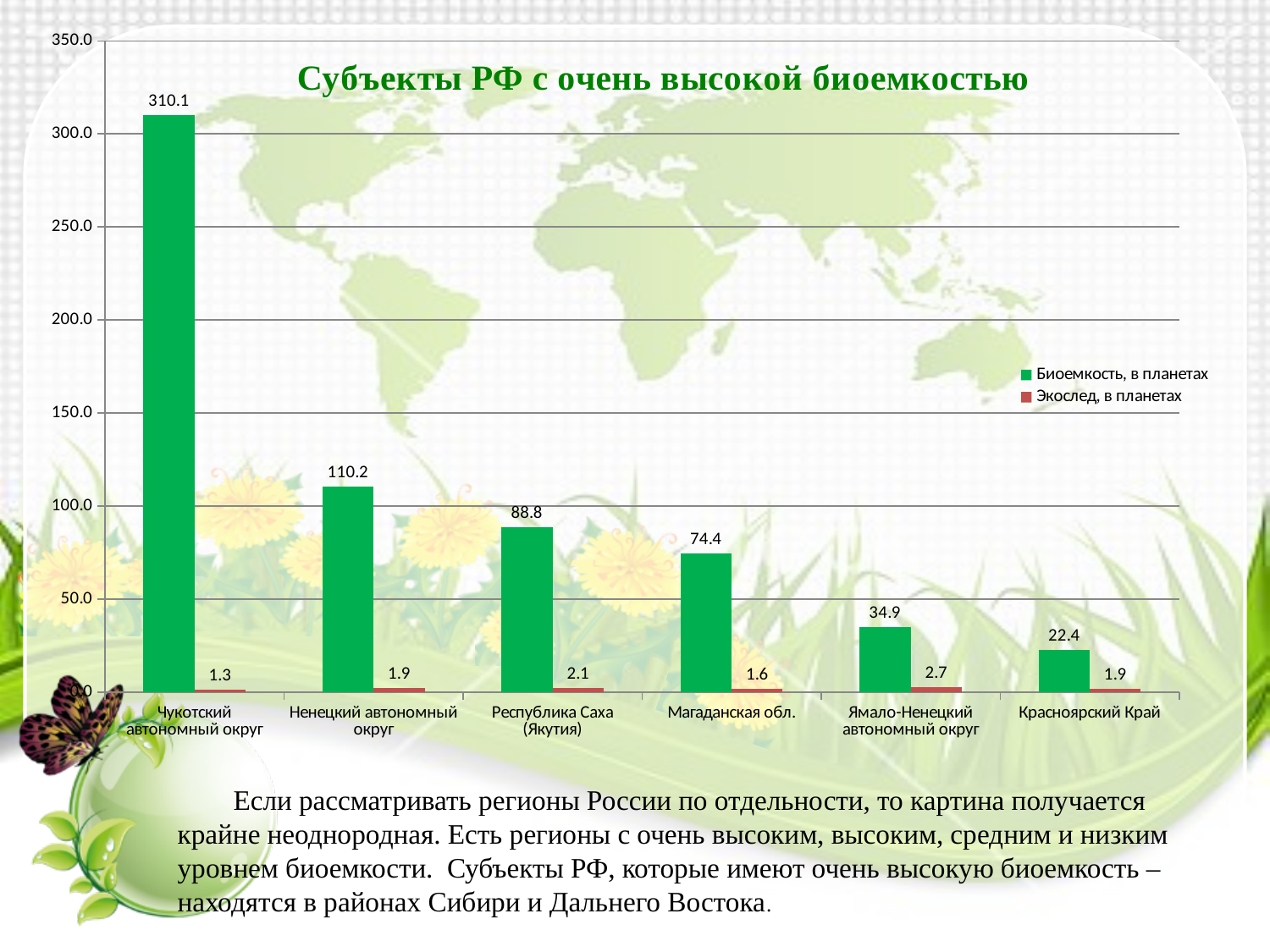
What is the value of Биоемкость, в планетах for Чукотский автономный округ? 310.1 What is the difference between the Биоемкость, в планетах values for Ненецкий автономный округ and Республика Саха (Якутия)? 21.4 What is the value of Экослед, в планетах for Ямало-Ненецкий автономный округ? 2.7 What is the value of Биоемкость, в планетах for Магаданская обл.? 74.4 What kind of chart is shown on the slide? Bar chart How many categories are shown on the x axis? 6 How many series does the legend list? 2 Which is larger: the Биоемкость, в планетах value for Ямало-Ненецкий автономный округ or for Красноярский Край? Ямало-Ненецкий автономный округ What is the title of the chart? Субъекты РФ с очень высокой биоемкостью Which category has the lowest value of Экослед, в планетах? Чукотский автономный округ Which category has the lowest value of Биоемкость, в планетах? Красноярский Край Which category has the highest value of Биоемкость, в планетах? Чукотский автономный округ